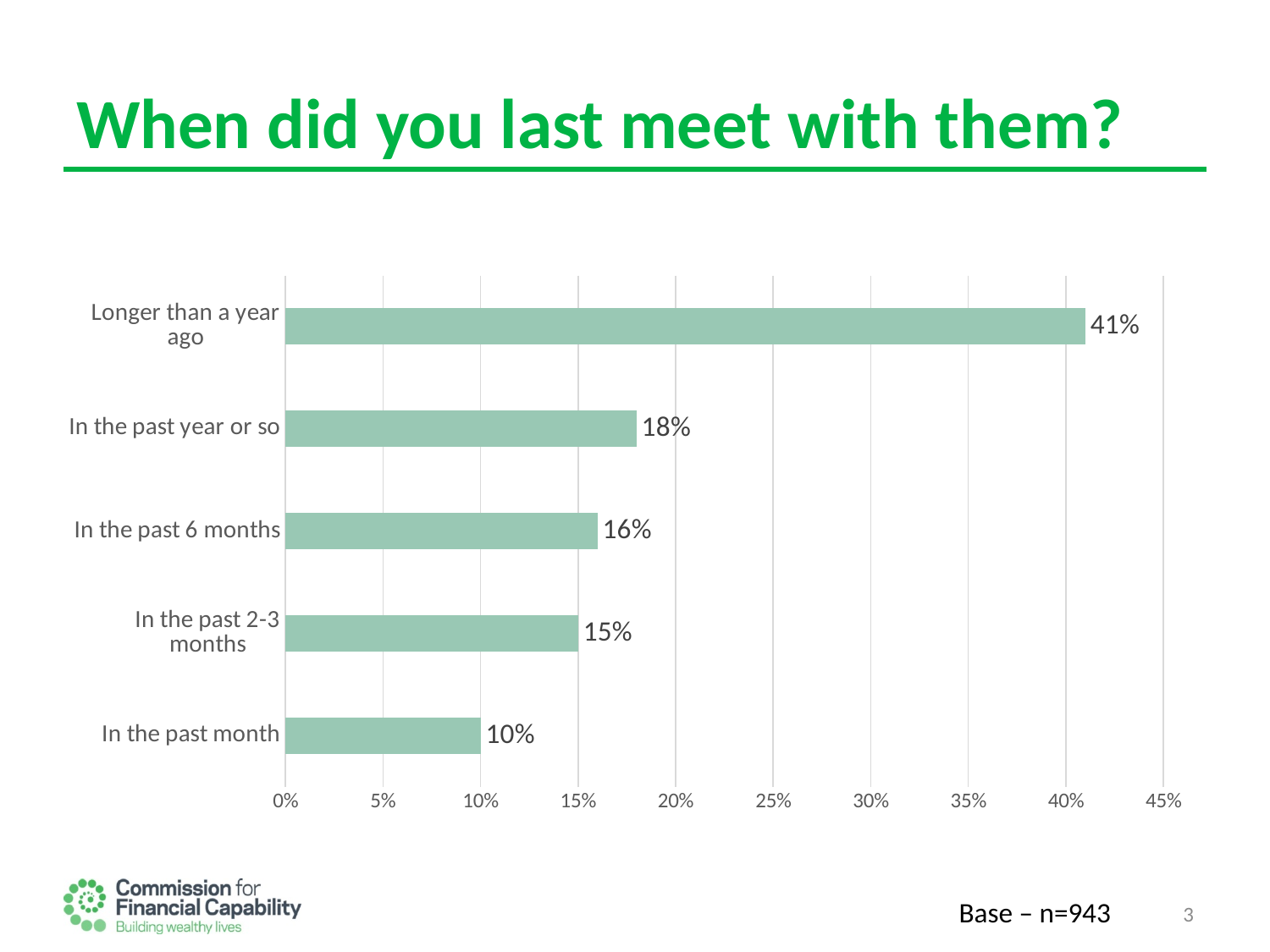
Which is larger, 'In the past year or so' or 'In the past 2-3 months'? In the past year or so What kind of chart is shown on the slide? Bar chart What is the value for 'In the past 6 months'? 16% What percentage of respondents last met with them longer than a year ago? 41% What is the difference between 'In the past 6 months' and 'In the past month'? 6% What is the value for 'In the past month'? 10% What is the value for 'In the past 2-3 months'? 15% Which category has the highest value? Longer than a year ago How many categories are shown in the chart? 5 Which category has the lowest value? In the past month What is the title of the slide? When did you last meet with them? What is the difference between 'Longer than a year ago' and 'In the past year or so'? 23%